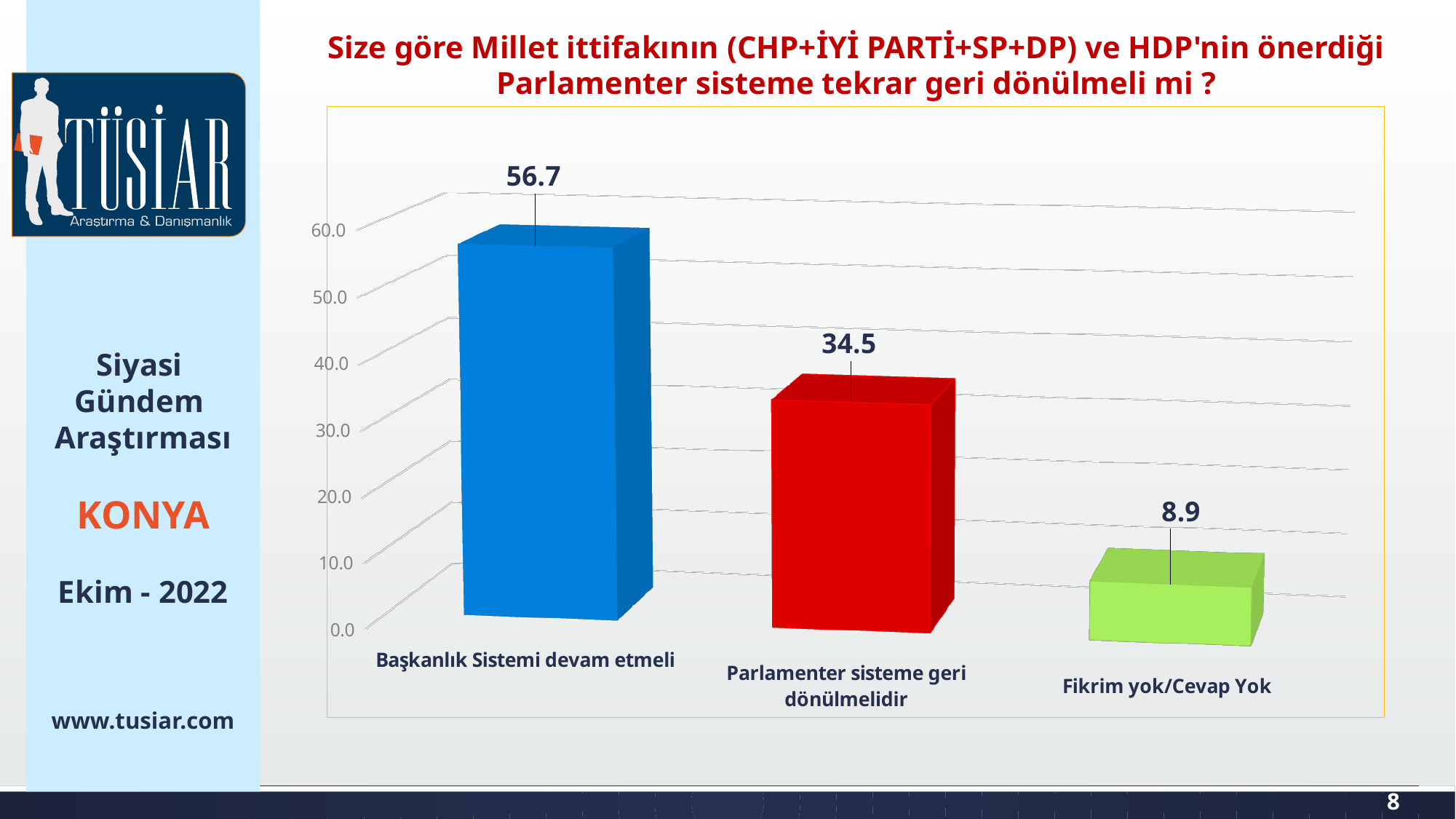
How many categories are shown in the chart? 3 What is the value for "Başkanlık Sistemi devam etmeli"? 56.7 Which category has the lowest value? Fikrim yok/Cevap Yok What is the difference between the values for "Başkanlık Sistemi devam etmeli" and "Parlamenter sisteme geri dönülmelidir"? 22.2 What is the difference between the values for "Parlamenter sisteme geri dönülmelidir" and "Fikrim yok/Cevap Yok"? 25.6 What colour is the bar for "Parlamenter sisteme geri dönülmelidir"? Red What is the value for "Parlamenter sisteme geri dönülmelidir"? 34.5 What kind of chart is shown on the slide? Bar chart Is the value for "Başkanlık Sistemi devam etmeli" greater or less than 50.0? greater Which category has the highest value? Başkanlık Sistemi devam etmeli Which is larger: the value for "Parlamenter sisteme geri dönülmelidir" or the value for "Fikrim yok/Cevap Yok"? Parlamenter sisteme geri dönülmelidir What is the value for "Fikrim yok/Cevap Yok"? 8.9